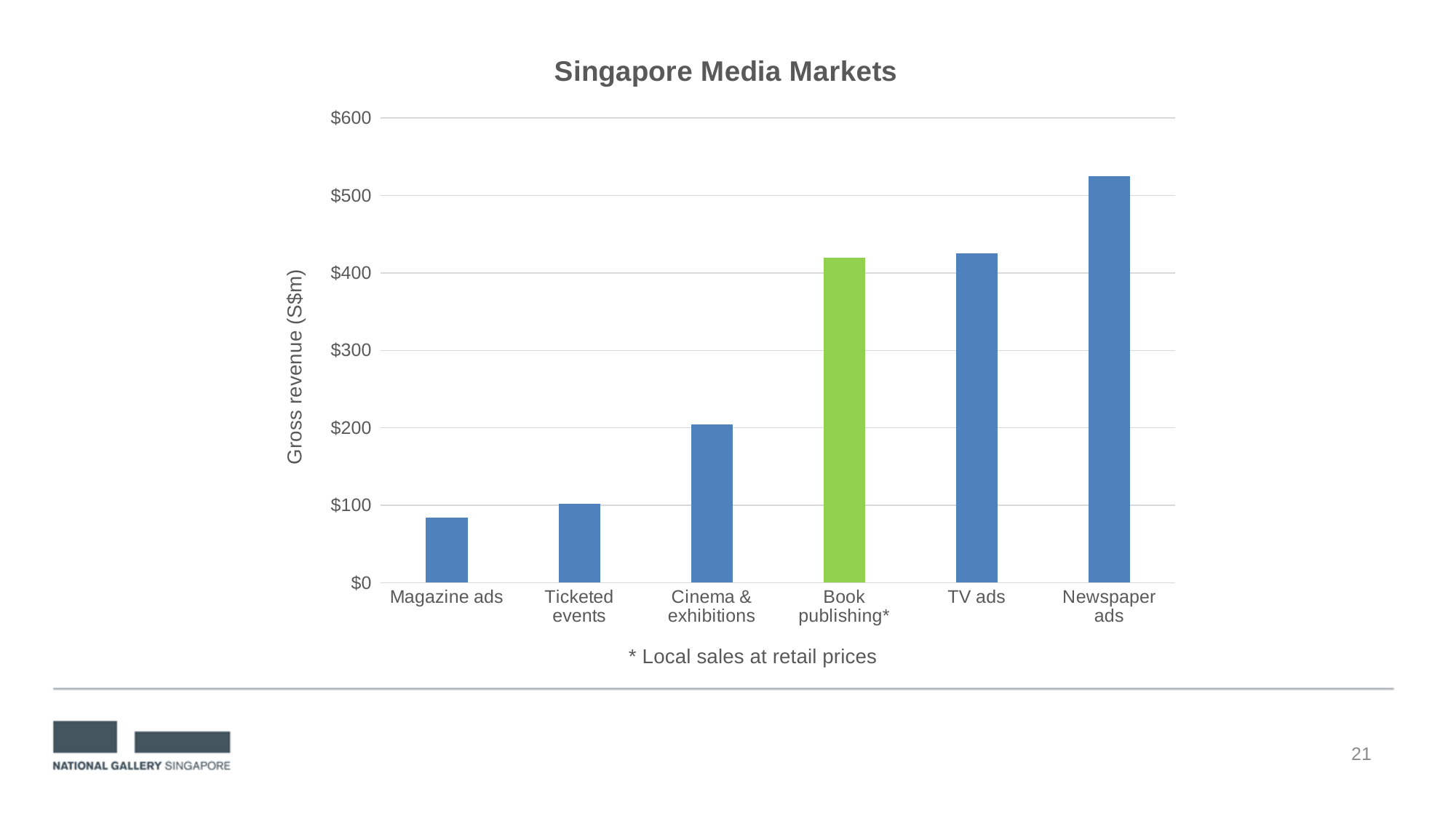
Which category's bar is coloured green rather than blue? Book publishing* Which category has the lowest gross revenue? Magazine ads What is the title of the chart? Singapore Media Markets What type of chart is shown on the slide? Bar chart Is the value for Cinema & exhibitions greater or less than $300? less Do the values rise or fall moving from left to right along the x axis? Rise Is the value for Book publishing* greater or less than $400? greater Is the value for Magazine ads greater or less than $100? less Which is larger, the value for Cinema & exhibitions or the value for TV ads? TV ads Which category has the highest gross revenue? Newspaper ads How many categories are plotted in the chart? 6